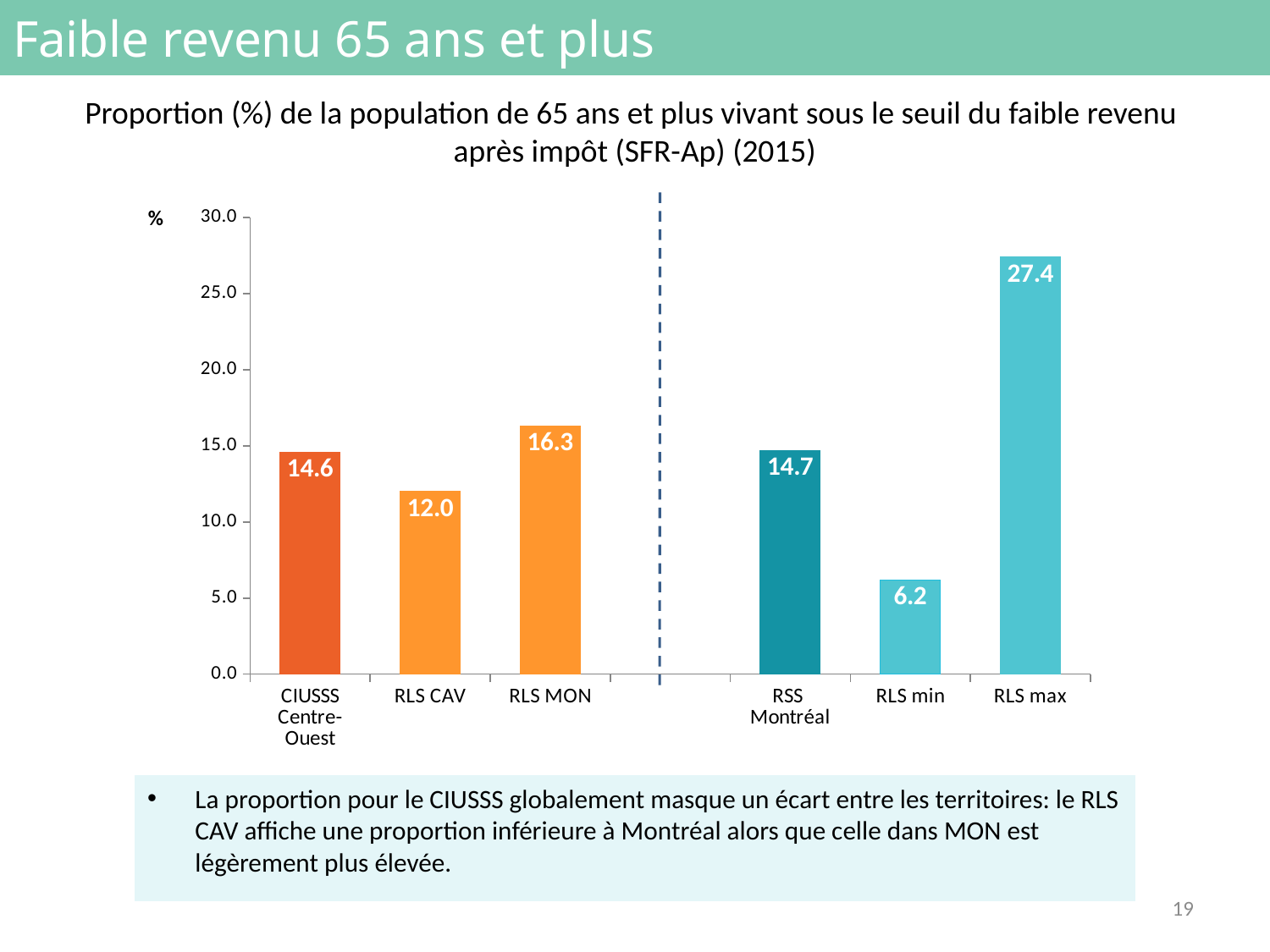
What is the difference between the values for RLS MON and RLS CAV? 4.3 What is the value for RLS CAV? 12.0 What is the value for RSS Montréal? 14.7 What is the difference between the values for RLS max and RLS min? 21.2 What kind of chart is shown on the slide? bar chart Which is larger, the value for RLS CAV or the value for RLS MON? RLS MON What is the value for RLS MON? 16.3 Which category has the lowest value? RLS min Which category has the highest value? RLS max What is the value for CIUSSS Centre-Ouest? 14.6 How many categories are shown on the x axis? 6 Is the value for RLS max greater or less than 25.0? greater